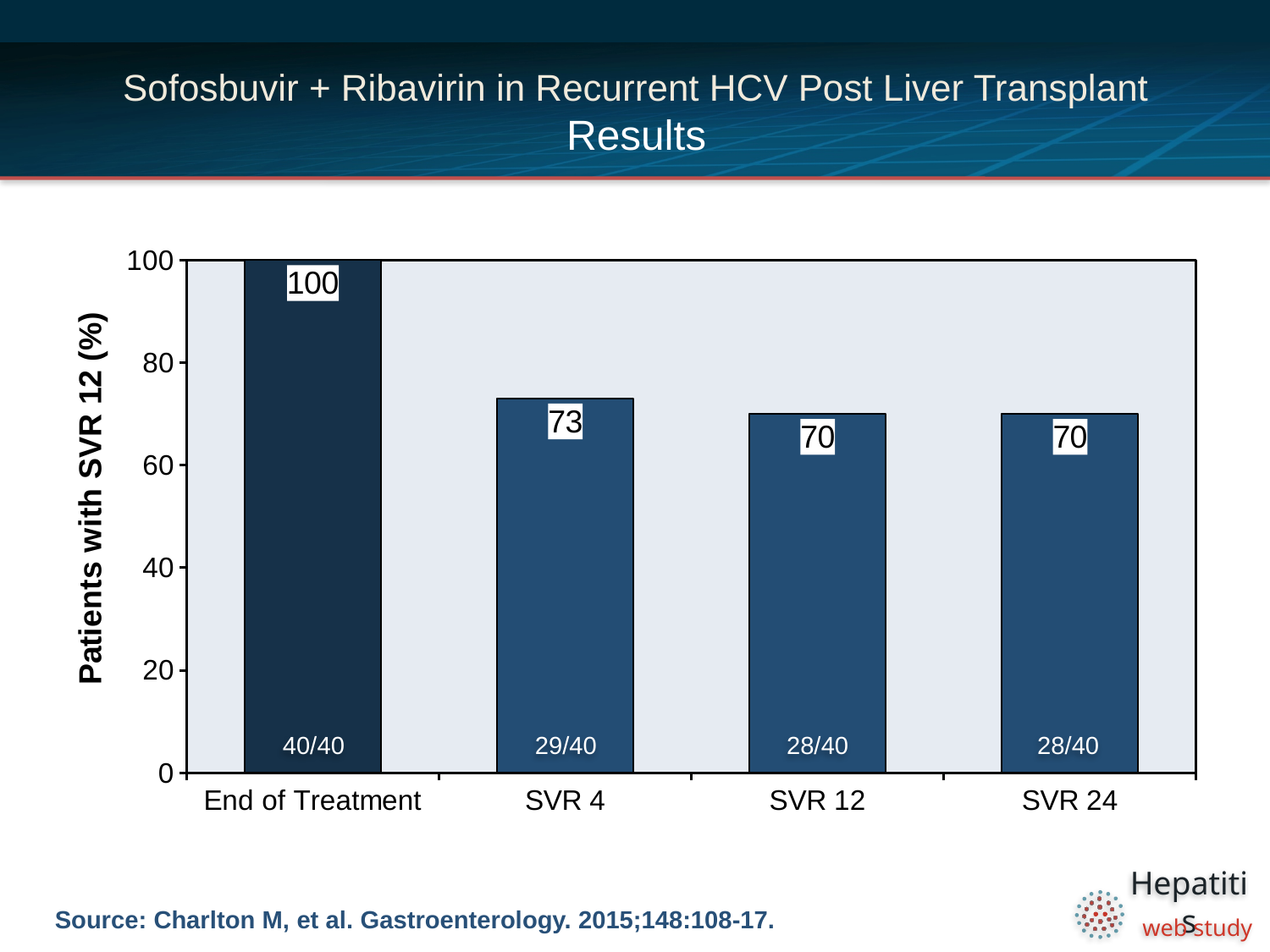
Is the value for SVR 4 greater or less than 80? less How many categories are shown on the x axis? 4 What is the difference between the SVR 4 value and the SVR 12 value? 3 Which is larger, the value for End of Treatment or the value for SVR 24? End of Treatment What fraction of patients is shown inside the SVR 24 bar? 28/40 Which category has the highest value? End of Treatment What is the value for SVR 12? 70 What is the label of the y axis? Patients with SVR 12 (%) What is the difference between the End of Treatment value and the SVR 4 value? 27 What kind of chart is shown on the slide? bar chart What is the value for End of Treatment? 100 What is the value for SVR 4? 73